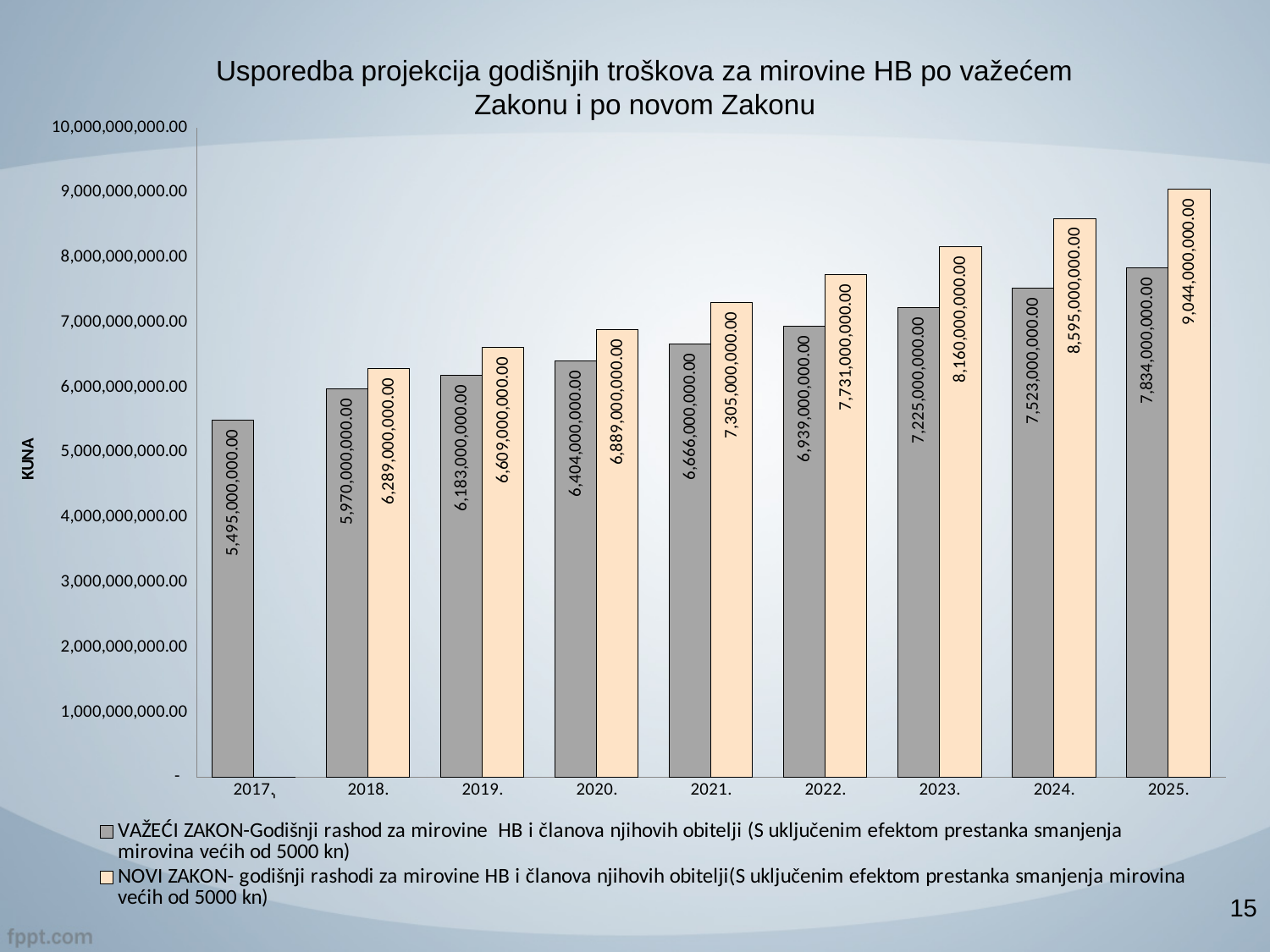
How many years are shown on the x axis? 9 In which year is the NOVI ZAKON value highest? 2025 What type of chart is shown on the slide? Bar chart In which year is the VAŽEĆI ZAKON value lowest? 2017 How many series does the legend list? 2 What is the value for NOVI ZAKON in 2020? 6,889,000,000.00 What is the value for VAŽEĆI ZAKON in 2022? 6,939,000,000.00 What is the difference between the NOVI ZAKON and VAŽEĆI ZAKON values in 2025? 1,210,000,000.00 What is the value for VAŽEĆI ZAKON in 2017? 5,495,000,000.00 Which is larger in 2023: the VAŽEĆI ZAKON value or the NOVI ZAKON value? NOVI ZAKON What is the value for NOVI ZAKON in 2025? 9,044,000,000.00 Do the VAŽEĆI ZAKON values rise or fall from 2017 to 2025? Rise